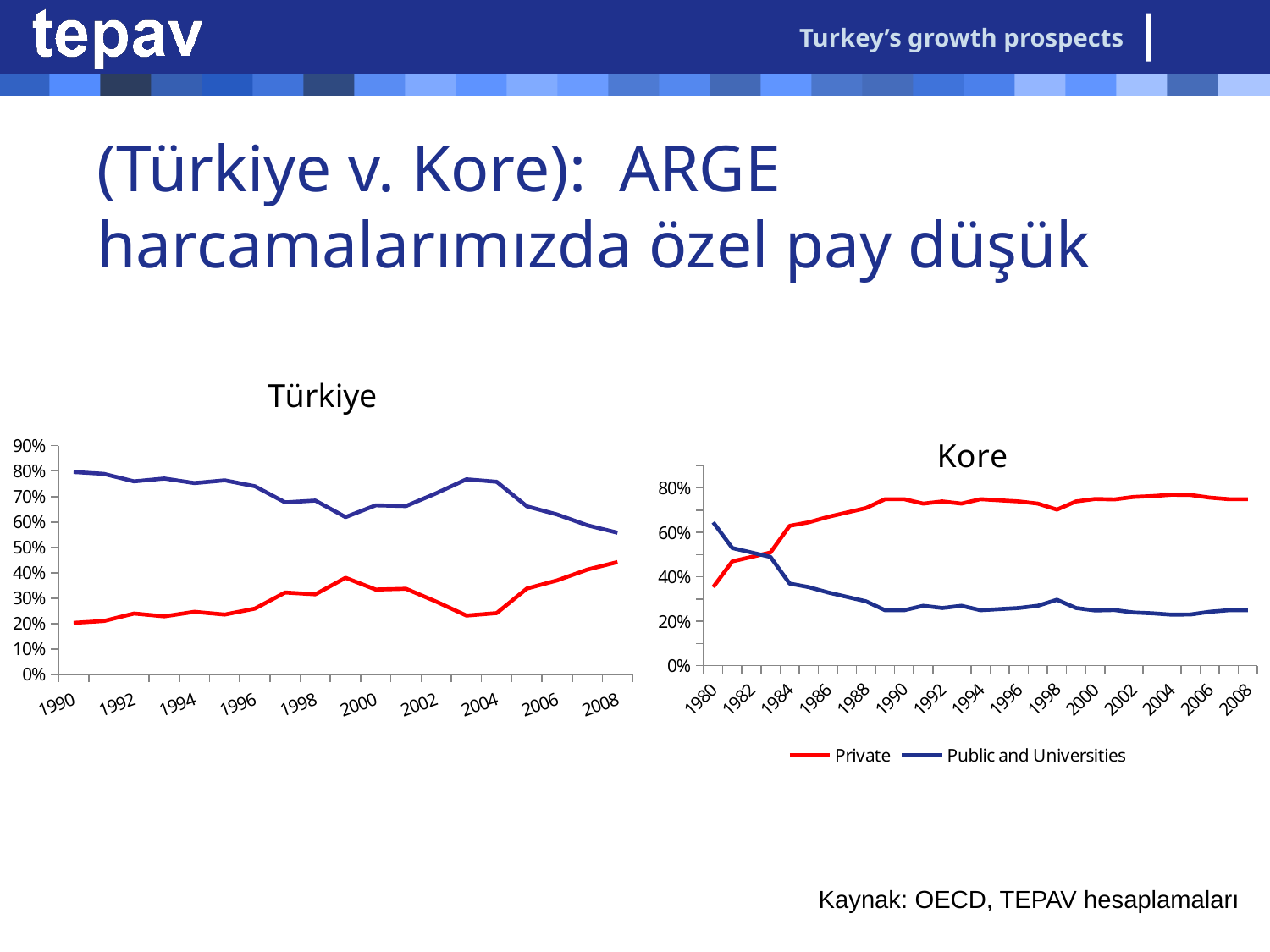
In the Kore chart, is the Public and Universities value for 2008 greater or less than 40%? less In the Kore chart, which series is shown in red? Private In the Kore chart, is the Private value for 1980 greater or less than 40%? less In the Kore chart, does the Public and Universities series rise or fall from 1980 to 2008? fall In the Türkiye chart, is the Private value for 2008 greater or less than 40%? greater How many series does the legend list for the charts? 2 In the Kore chart, does the Private series rise or fall from 1980 to 2008? rise In the Türkiye chart, which series is larger in 2008, Private or Public and Universities? Public and Universities What kind of chart is the Türkiye chart? Line chart In the Kore chart, which series is larger in 2008, Private or Public and Universities? Private